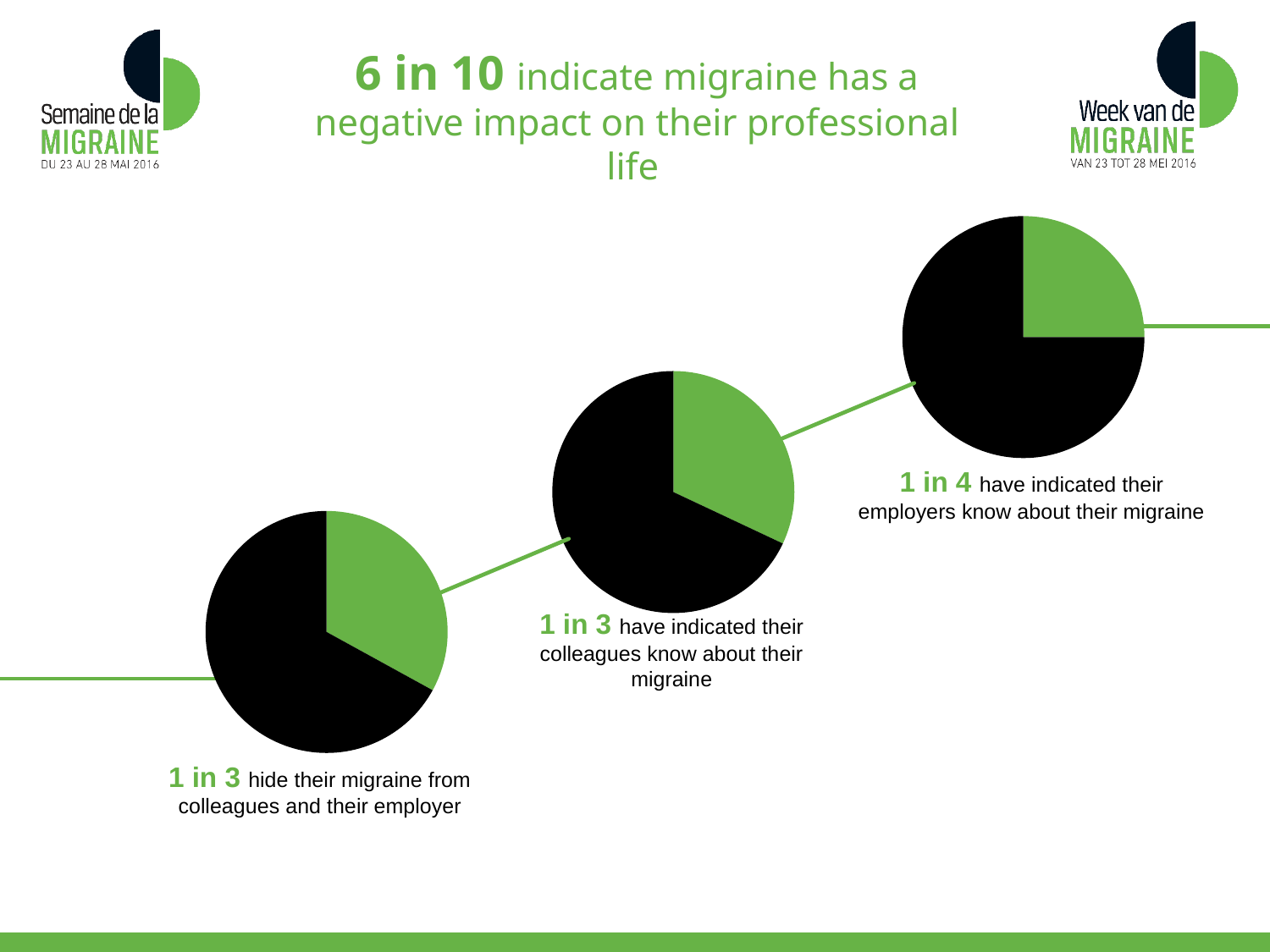
According to the top-right pie chart, what share of people have indicated their employers know about their migraine? 1 in 4 In each pie chart, is the highlighted share shown in green or in black? Green Is the green slice larger in the pie chart about colleagues knowing about the migraine or in the pie chart about employers knowing about the migraine? Colleagues knowing According to the bottom-left pie chart, what share of people hide their migraine from colleagues and their employer? 1 in 3 According to the slide title, how many people indicate migraine has a negative impact on their professional life? 6 in 10 According to the middle pie chart, what share of people have indicated their colleagues know about their migraine? 1 in 3 How many slices does each pie chart have? 2 How many pie charts are on the slide? 3 What kind of charts are shown on the slide? Pie charts Which pie chart has the smallest green slice: the one about hiding migraine, the one about colleagues knowing, or the one about employers knowing? The one about employers knowing